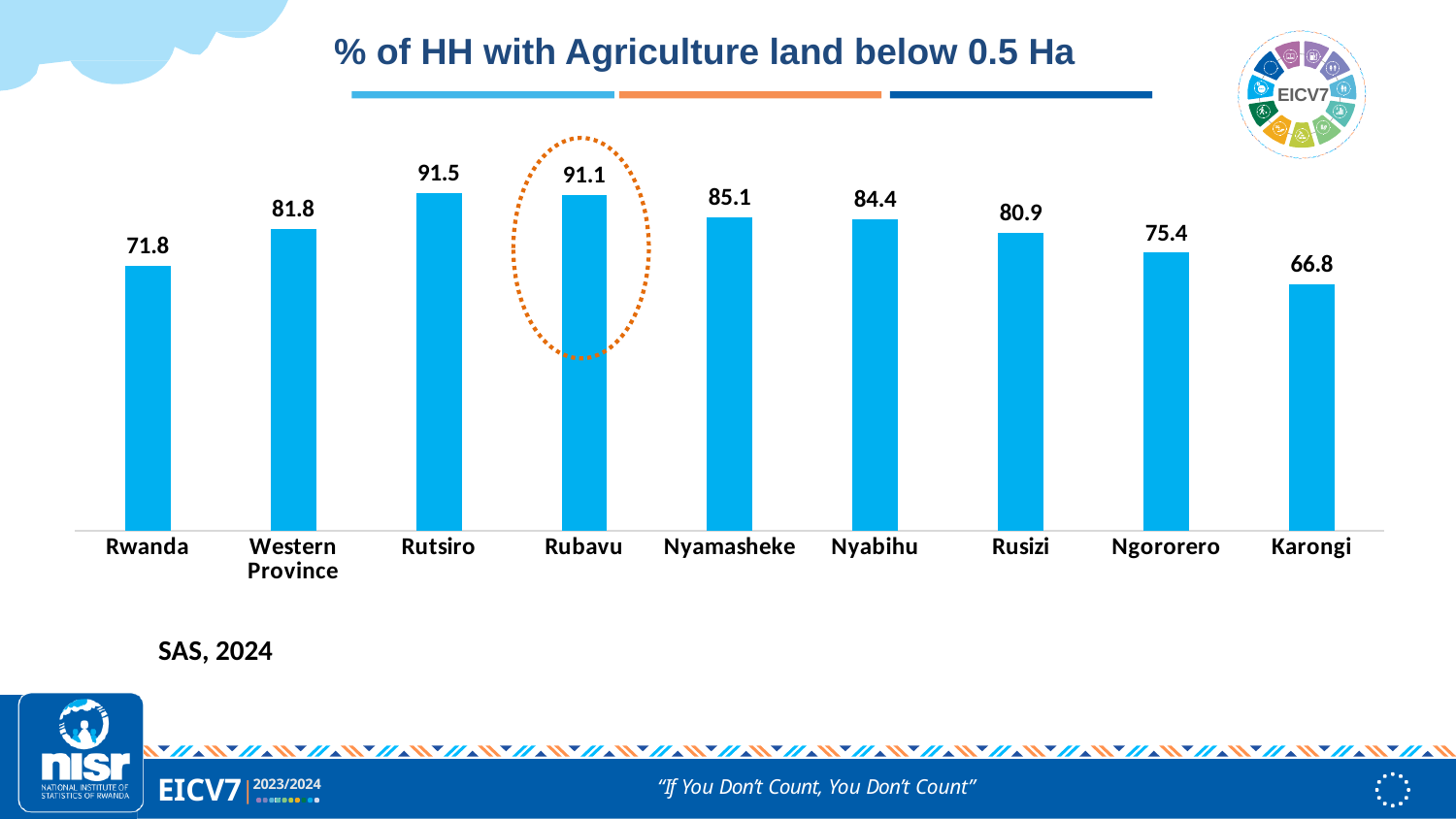
What is the difference between the values for Rutsiro and Karongi? 24.7 Which category has the highest value? Rutsiro What is the title of the chart? % of HH with Agriculture land below 0.5 Ha What is the value for Western Province? 81.8 Which is larger, the value for Nyamasheke or the value for Rusizi? Nyamasheke What is the value for Rubavu? 91.1 What is the difference between the values for Western Province and Rwanda? 10 How many categories are shown on the x axis? 9 What kind of chart is shown on the slide? Bar chart Which category's bar is highlighted with an orange dotted circle? Rubavu Which category has the lowest value? Karongi What is the value for Karongi? 66.8